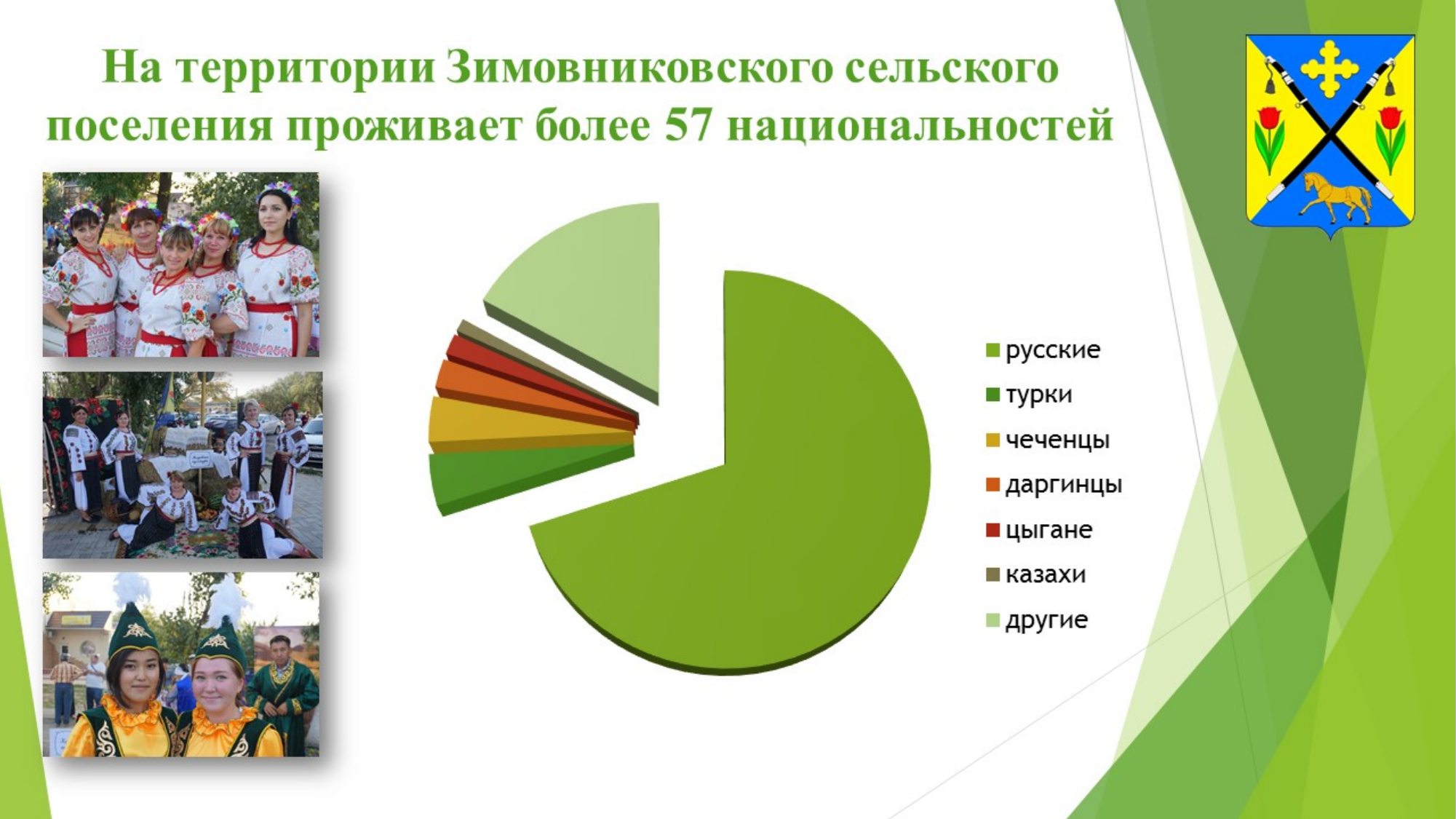
Which category is listed last in the legend of the pie chart? другие How many entries does the legend of the pie chart list? 7 What kind of chart is shown on the slide? pie chart Which slice is larger, русские or другие? русские How many categories (slices) does the pie chart have? 7 Which category has the largest slice in the pie chart? русские Which category is listed first in the legend of the pie chart? русские Which slice is larger, чеченцы or казахи? чеченцы Which slice is larger, другие or чеченцы? другие